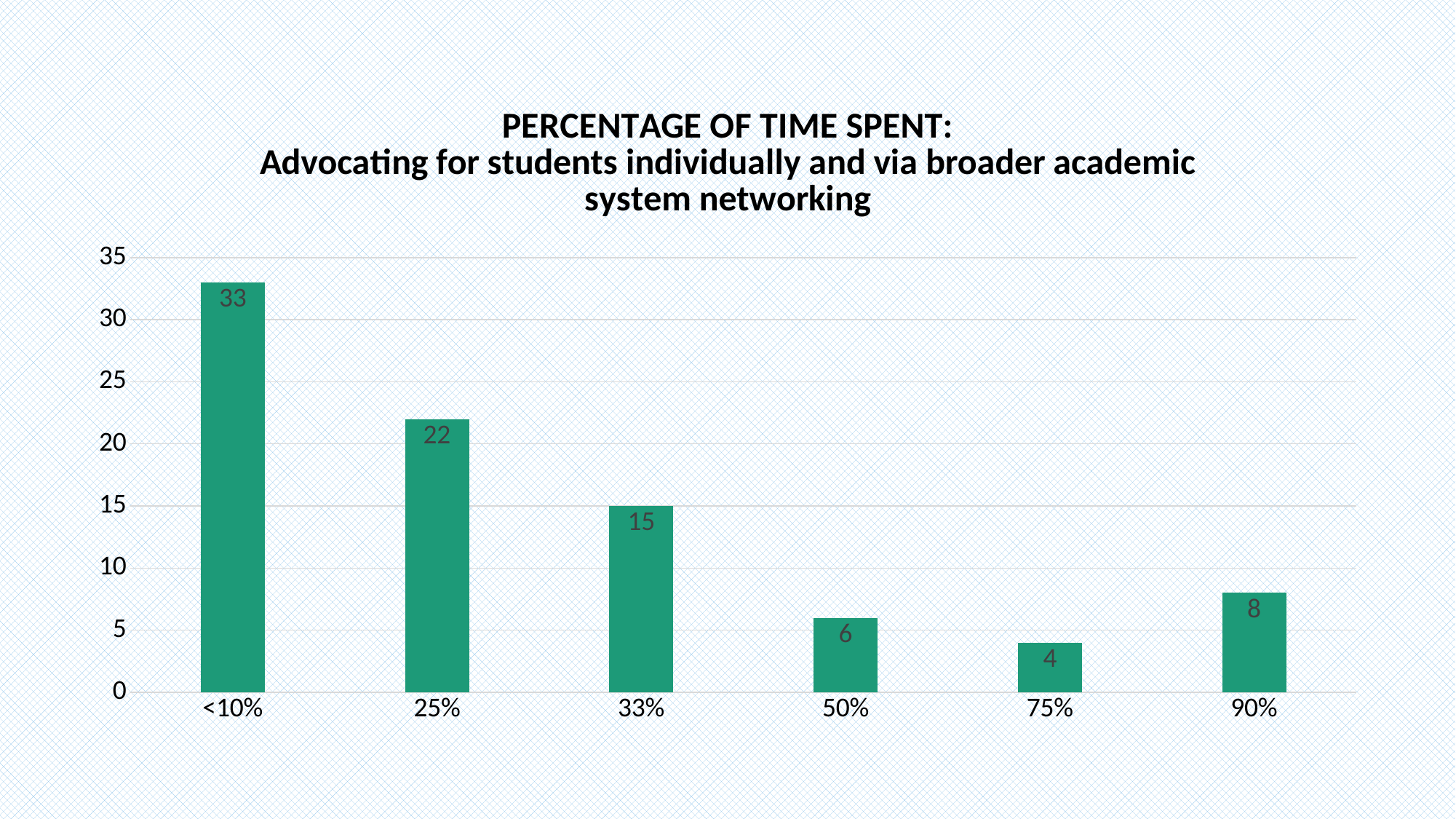
Which category has the highest value? <10% What is the value for the 25% category? 22 Which is larger, the value for 50% or the value for 90%? 90% Which category has the lowest value? 75% What is the difference between the values for 33% and 50%? 9 What is the value for the 90% category? 8 How many categories are shown on the x axis? 6 What is the value for the 75% category? 4 What kind of chart is shown on the slide? Bar chart What is the value for the <10% category? 33 What is the first line of the chart title? PERCENTAGE OF TIME SPENT: What is the difference between the values for <10% and 25%? 11